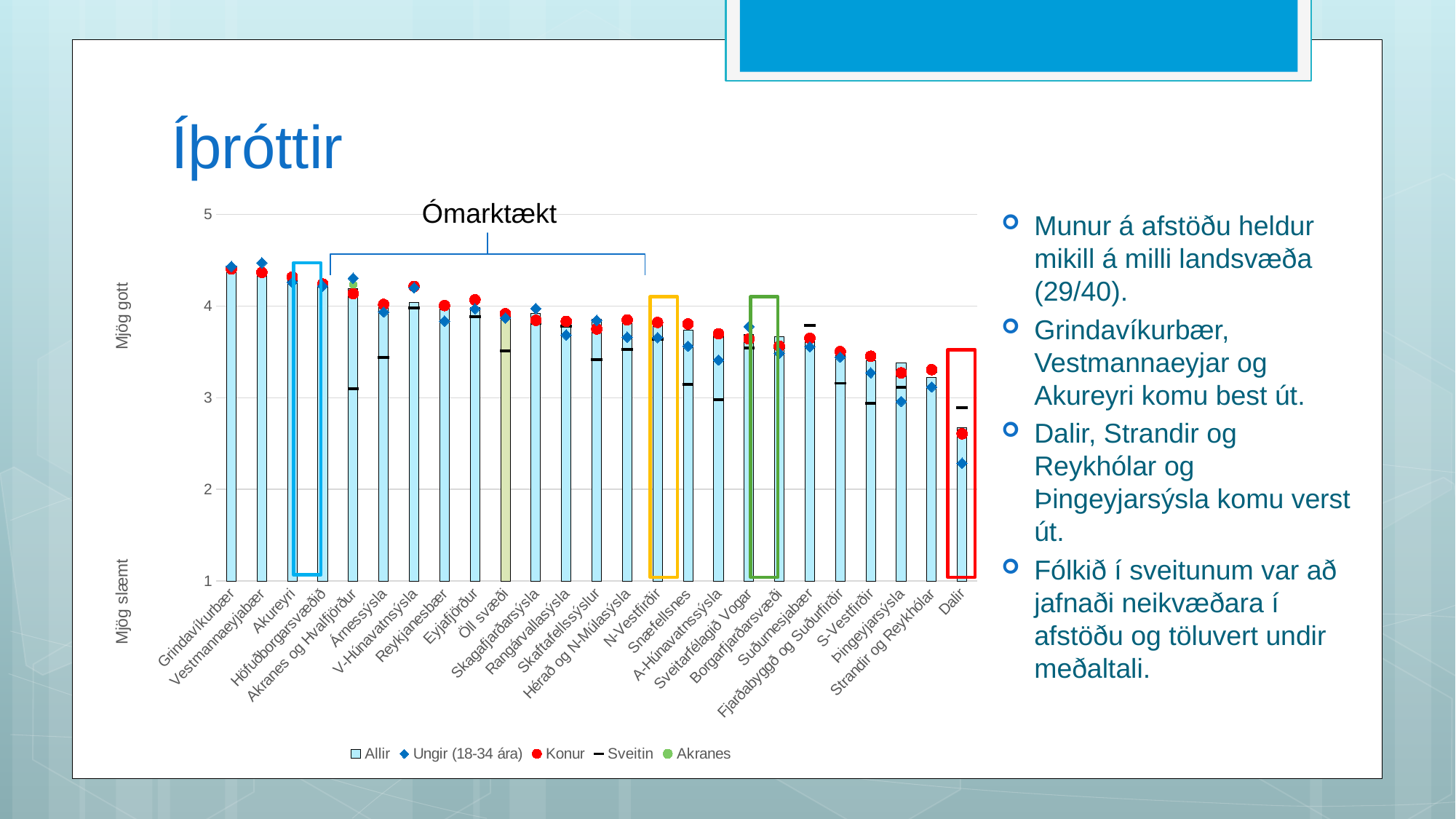
How many series does the chart legend list? 5 Is the 'Ungir (18-34 ára)' value for Dalir greater or less than 3? less Is the 'Allir' value for Dalir greater or less than 3? less How many regions (categories) are shown along the x axis of the chart? 25 What kind of chart is shown on the slide? bar chart Which has the larger 'Konur' value, Grindavíkurbær or Dalir? Grindavíkurbær Do the 'Allir' bar values generally rise or fall from left to right along the x axis? fall Is the 'Sveitin' value for Árnessýsla greater or less than 4? less Which region has the lowest 'Allir' bar in the chart? Dalir What label is written above the bracket spanning the middle regions of the chart? Ómarktækt Which has the larger 'Allir' value, Akureyri or Þingeyjarsýsla? Akureyri